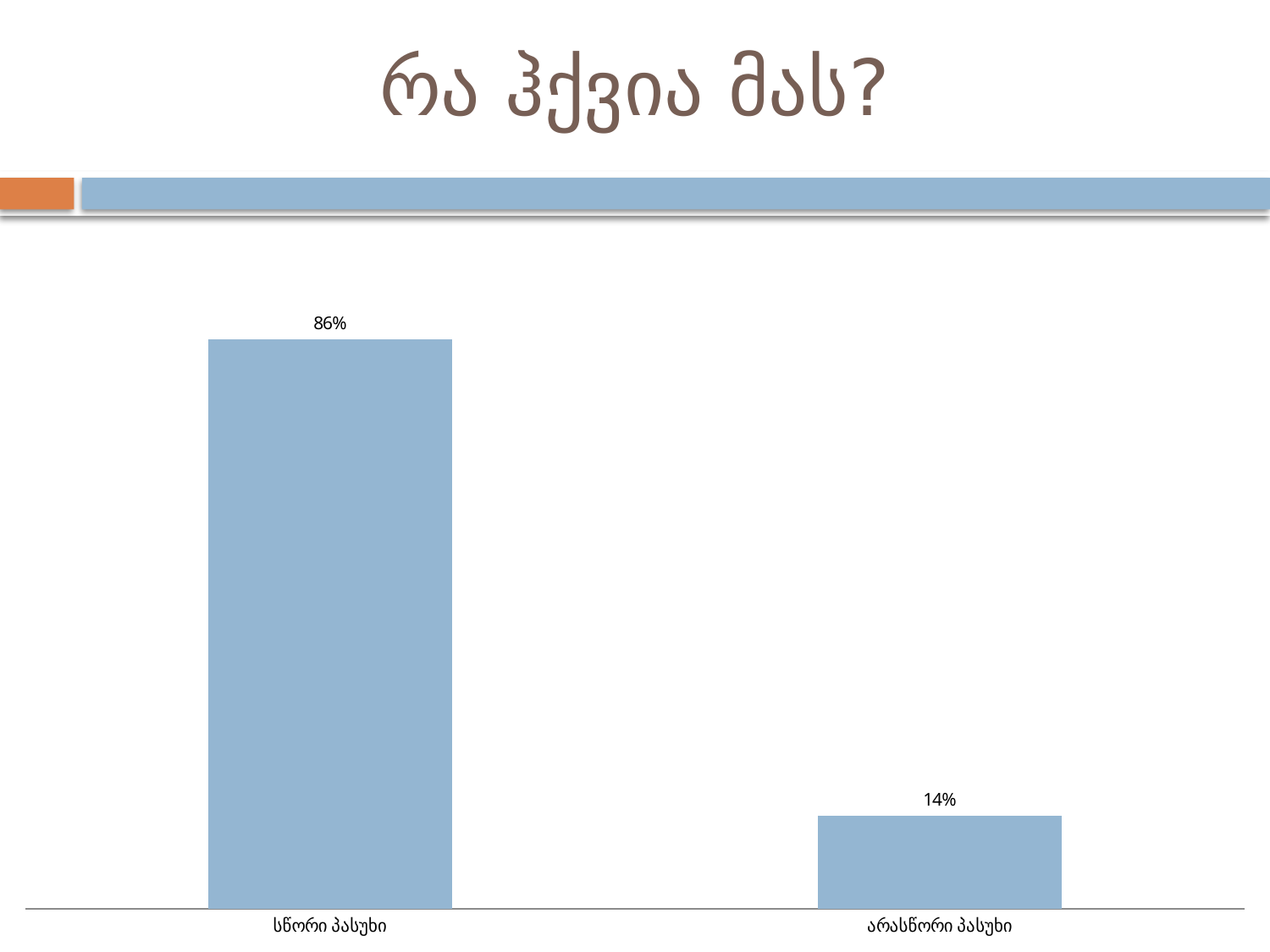
What colour are the bars in the chart? light blue What is the total of the two values shown in the chart? 100% What is the value for სწორი პასუხი? 86% Which category has the lowest value? არასწორი პასუხი What is the difference between the values for სწორი პასუხი and არასწორი პასუხი? 72% How many categories are shown in the chart? 2 Which category has the highest value? სწორი პასუხი What is the value for არასწორი პასუხი? 14% Which is larger, the value for სწორი პასუხი or the value for არასწორი პასუხი? სწორი პასუხი What is the title of the slide? რა ჰქვია მას? What kind of chart is shown on the slide? bar chart